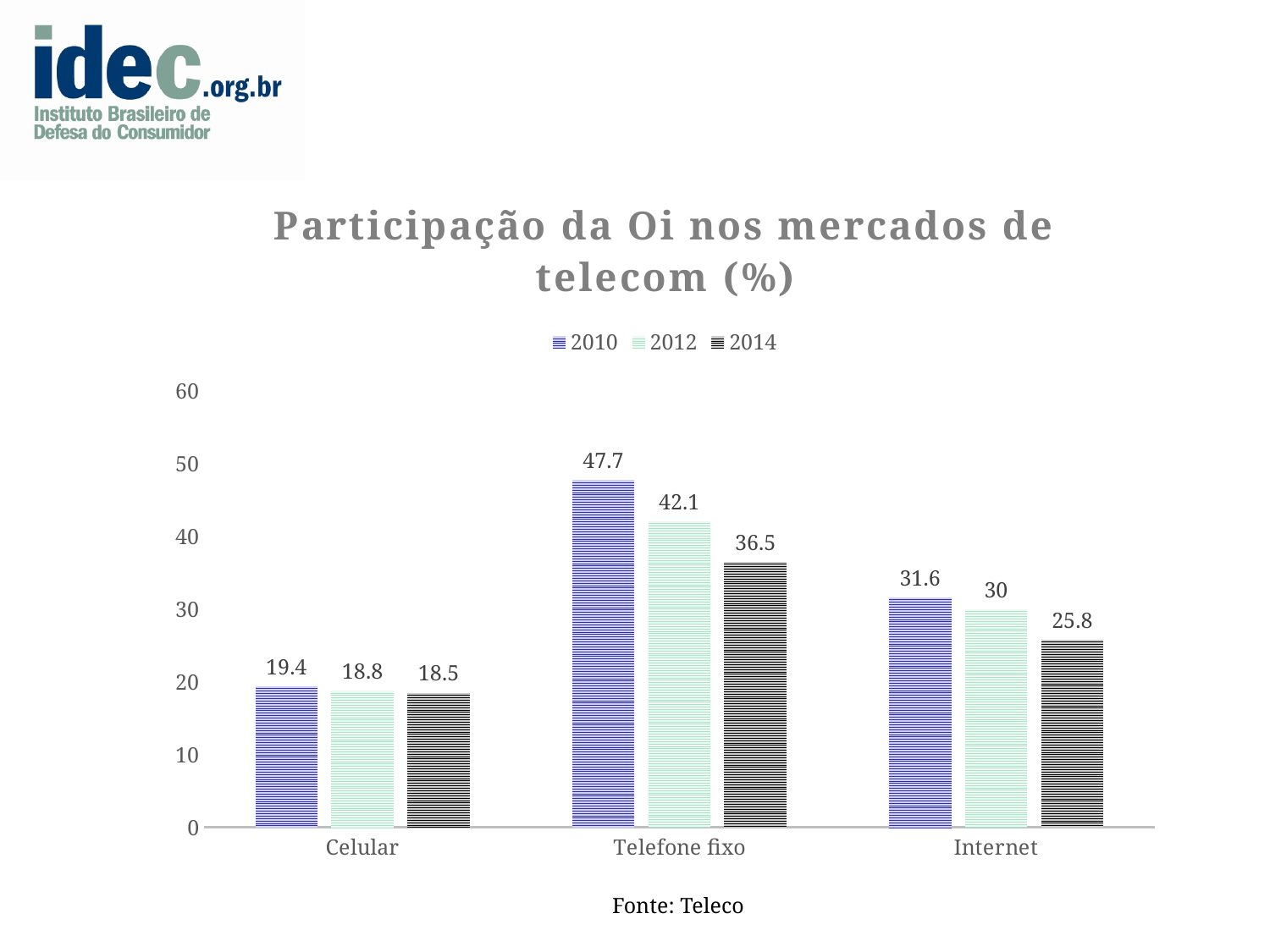
Which category has the lowest value in 2010? Celular What is the value for Celular in 2012? 18.8 How many categories are shown on the x axis? 3 What is the title of the chart? Participação da Oi nos mercados de telecom (%) Do the values for Internet rise or fall from 2010 to 2014? Fall Which is larger, the 2012 value for Internet or the 2014 value for Telefone fixo? 2014 value for Telefone fixo Which category has the highest value in 2014? Telefone fixo What is the difference between the 2010 and 2014 values for Telefone fixo? 11.2 How many series does the legend list? 3 What is the value for Internet in 2014? 25.8 What is the value for Telefone fixo in 2010? 47.7 What kind of chart is shown? Bar chart